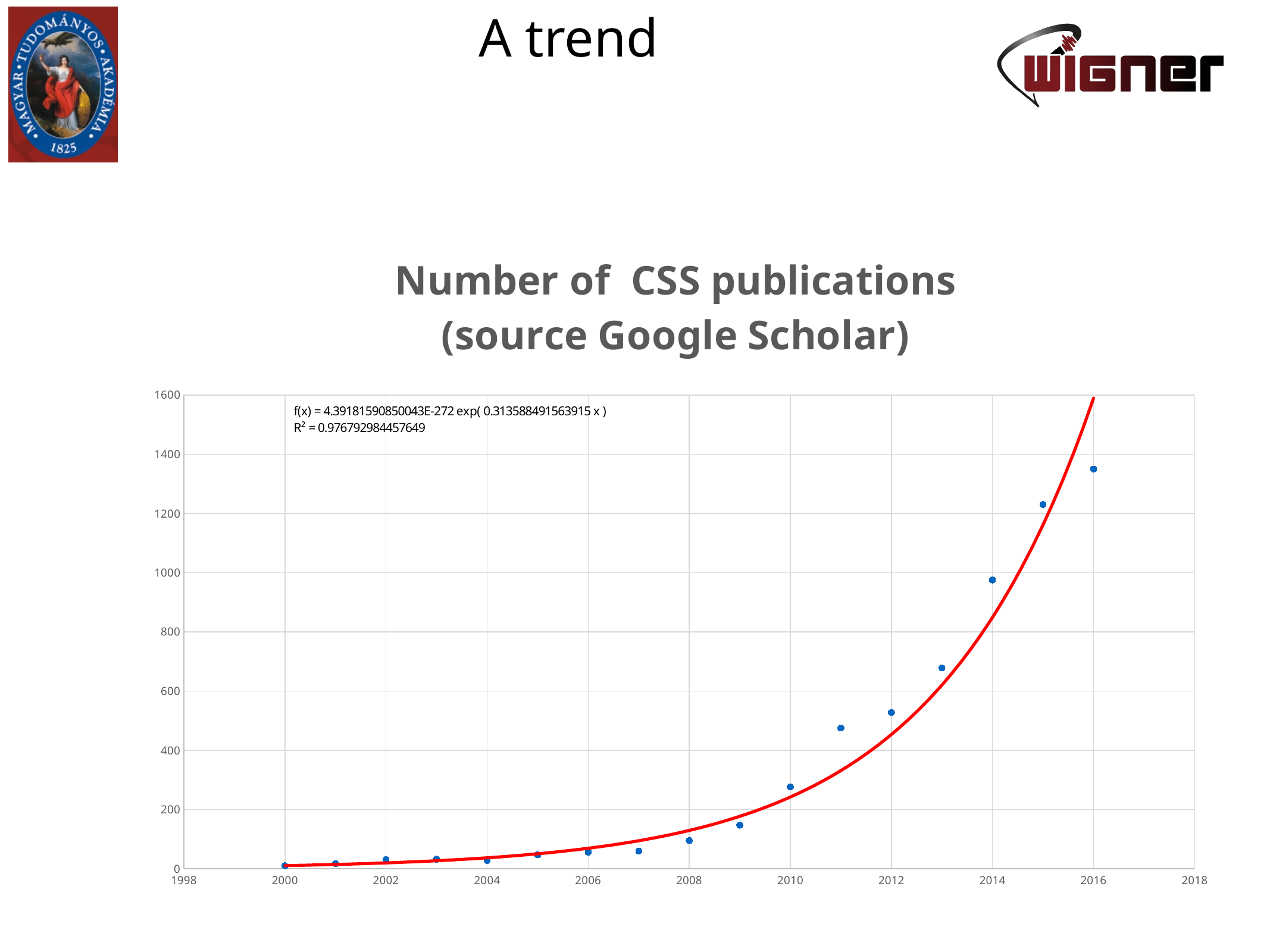
Which year has more CSS publications, 2014 or 2015? 2015 What kind of chart is shown on the slide? Scatter chart with a trend line Is the value for 2009 greater or less than 200? less How many data points are plotted in the chart? 17 Which year has the highest number of CSS publications? 2016 Is the value for 2013 greater or less than 800? less Is the value for 2014 greater or less than 800? greater What is the title of the chart? Number of CSS publications (source Google Scholar) Do the number of CSS publications rise or fall from 2000 to 2016? Rise What R² value is printed on the chart for the fitted trend line? 0.976792984457649 Which year has the lowest number of CSS publications? 2000